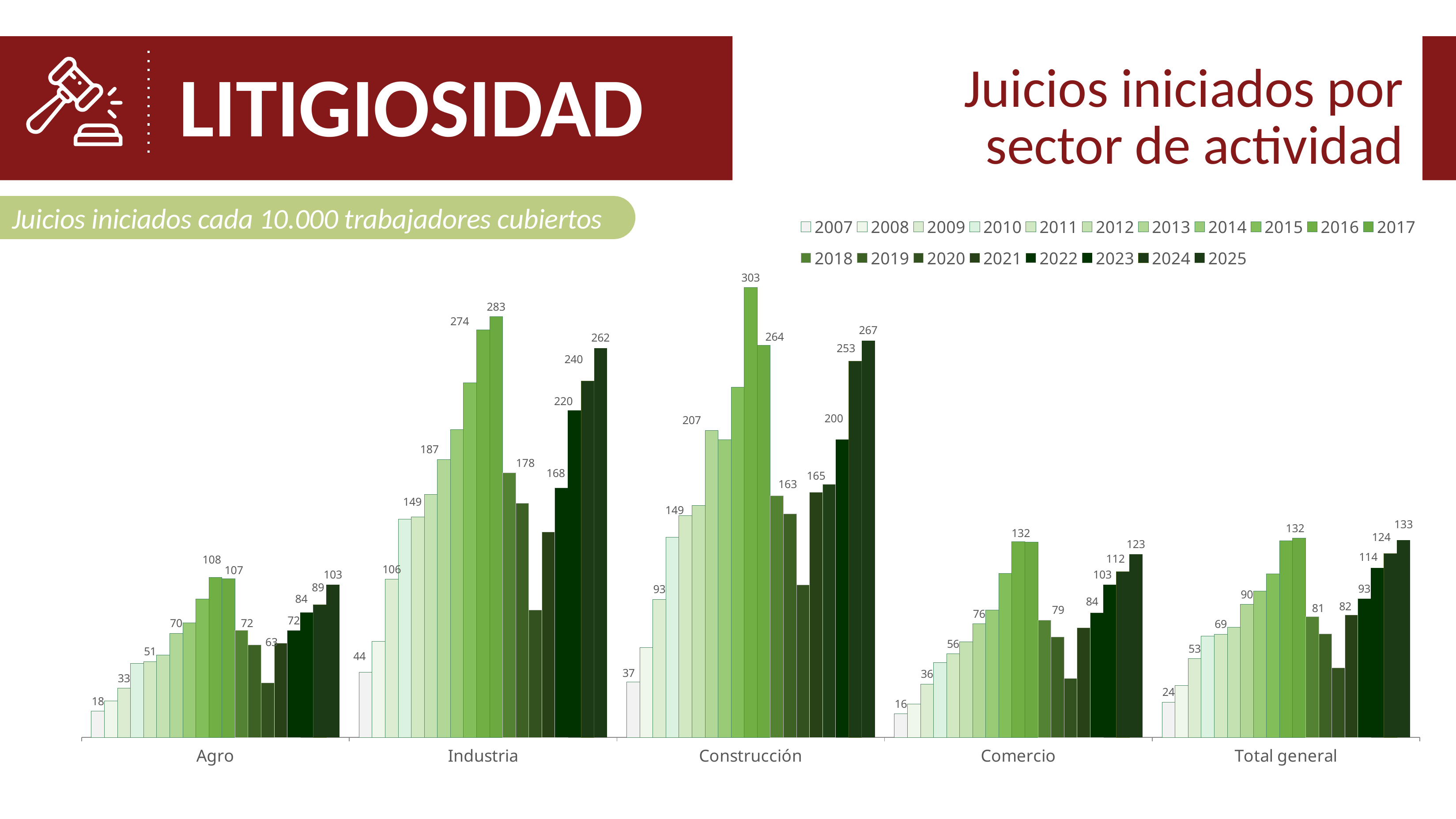
Which sector has the lowest value in 2007 (first bar of each group)? Comercio What is the value for Industria in 2007 (the first bar of the Industria group)? 44 What is the difference between the 2025 value (123) and the 2007 value (16) for Comercio? 107 What kind of chart is shown on the slide? bar chart What is the value for Total general in 2025 (the last bar of the Total general group)? 133 What is the highest value shown in the Construcción group? 303 Which is larger, the 2025 value for Industria or the 2025 value for Construcción? Construcción What is the highest value shown in the Industria group? 283 What is the value for Agro in 2007 (the first bar of the Agro group)? 18 What is the title of the chart on the slide? Juicios iniciados por sector de actividad How many sector categories are shown along the x axis of the chart? 5 How many years (series) does the chart legend list? 19